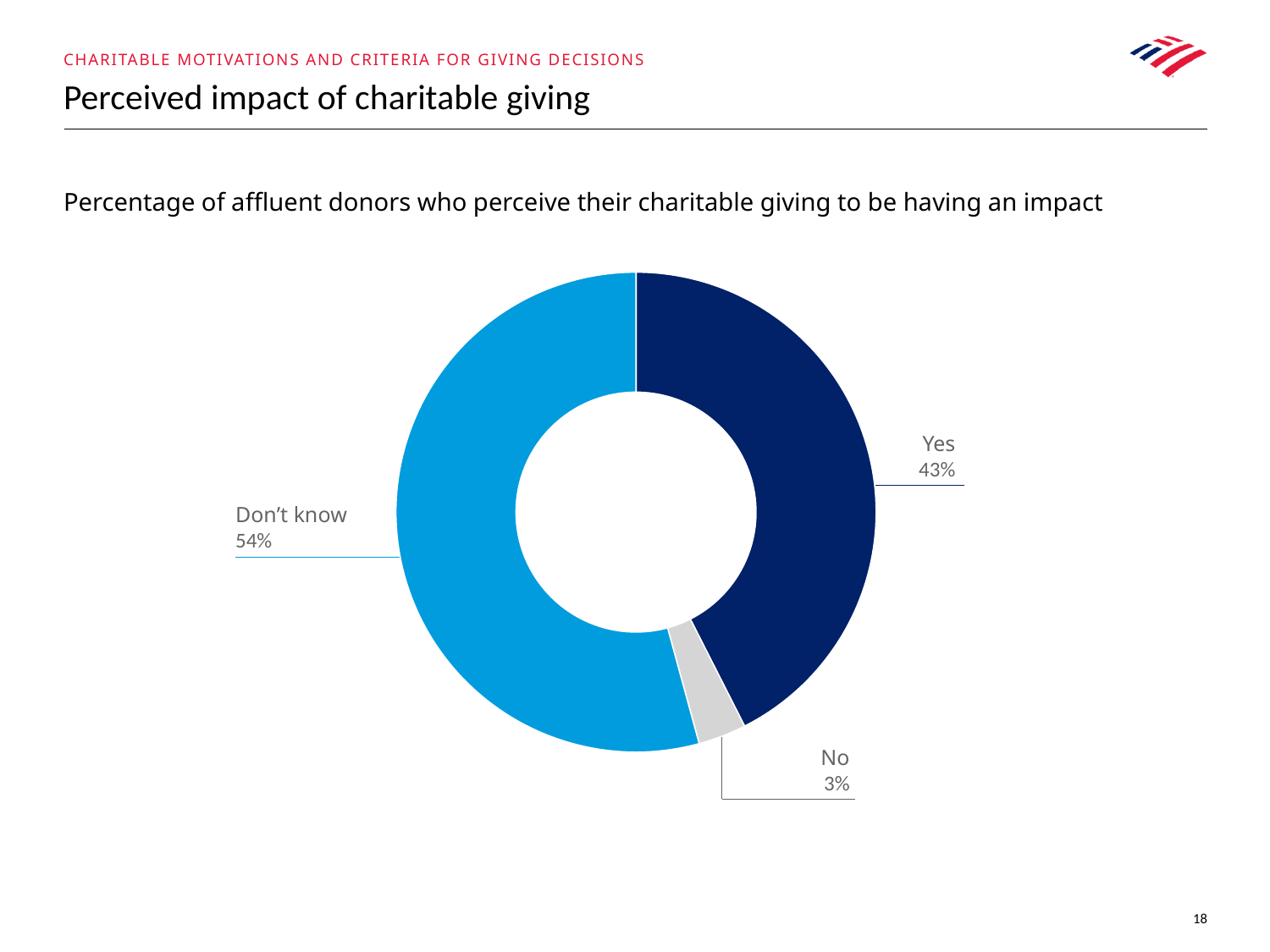
Which response has the smallest share of the chart? No What kind of chart is shown on the slide? Donut (pie) chart What colour is the "Don't know" segment of the chart? Light blue Which response has the largest share of the chart? Don't know What percentage of affluent donors answered "No"? 3% What is the difference in percentage points between "Don't know" and "Yes"? 11 What is the combined share of "Yes" and "No" responses? 46% Which is larger, the share for "Yes" or the share for "Don't know"? Don't know What percentage of affluent donors answered "Yes" that their charitable giving is having an impact? 43% What percentage of affluent donors answered "Don't know"? 54% What is the difference in percentage points between "Yes" and "No"? 40 How many response categories are shown in the chart? 3